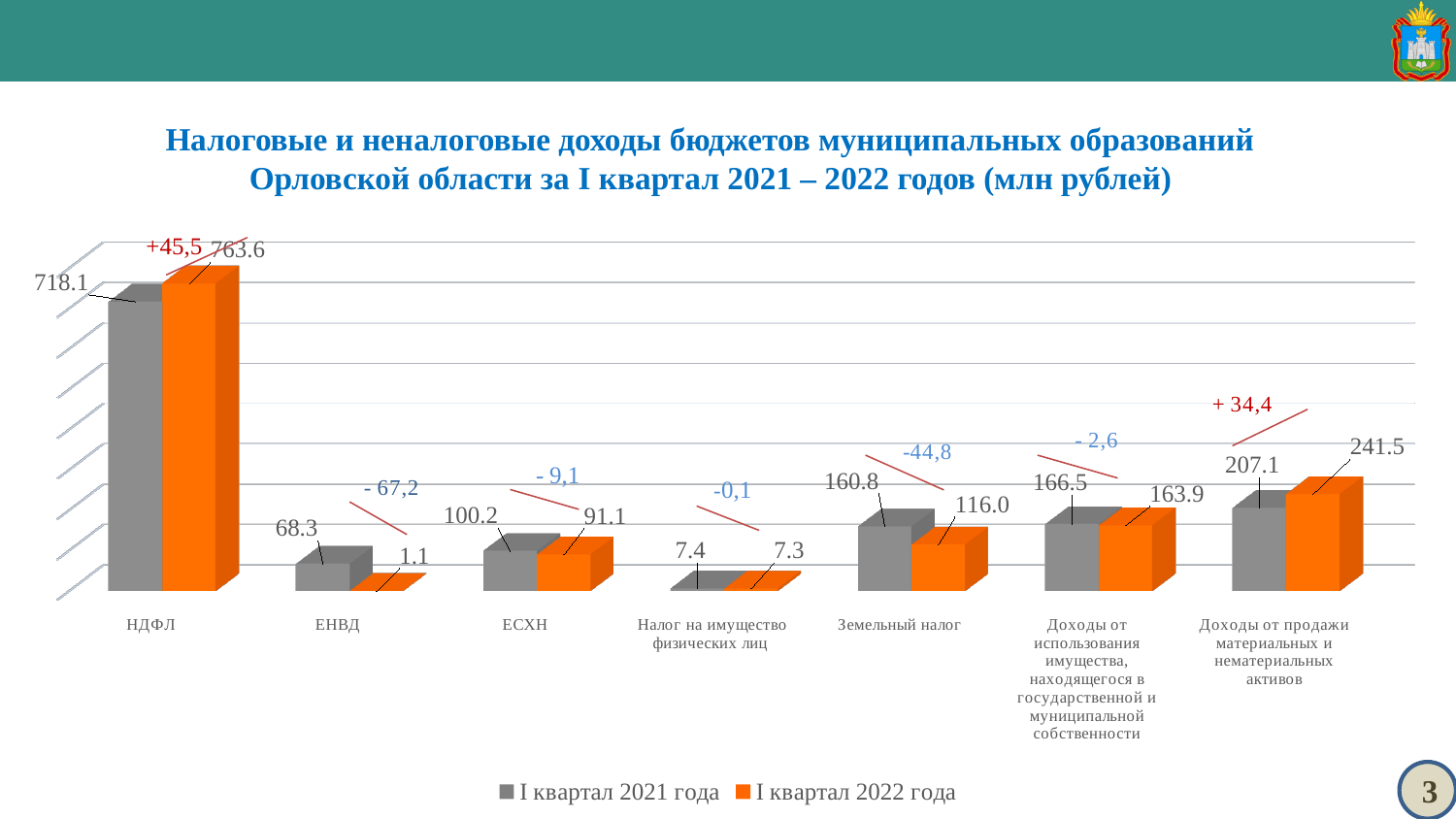
What is the value for НДФЛ in I квартал 2022 года? 763.6 What is the value for Доходы от продажи материальных и нематериальных активов in I квартал 2021 года? 207.1 Which category has the lowest value in I квартал 2022 года? ЕНВД What is the difference between the I квартал 2021 года and I квартал 2022 года values for Земельный налог? 44.8 How many series does the legend list? 2 Which category has the highest value in I квартал 2022 года? НДФЛ What kind of chart is shown on the slide? Bar chart What is the value for Земельный налог in I квартал 2022 года? 116.0 What is the difference between the I квартал 2022 года and I квартал 2021 года values for НДФЛ? 45.5 Which is larger for ЕСХН: the I квартал 2021 года value or the I квартал 2022 года value? I квартал 2021 года What is the value for ЕНВД in I квартал 2021 года? 68.3 How many categories are shown on the x axis? 7